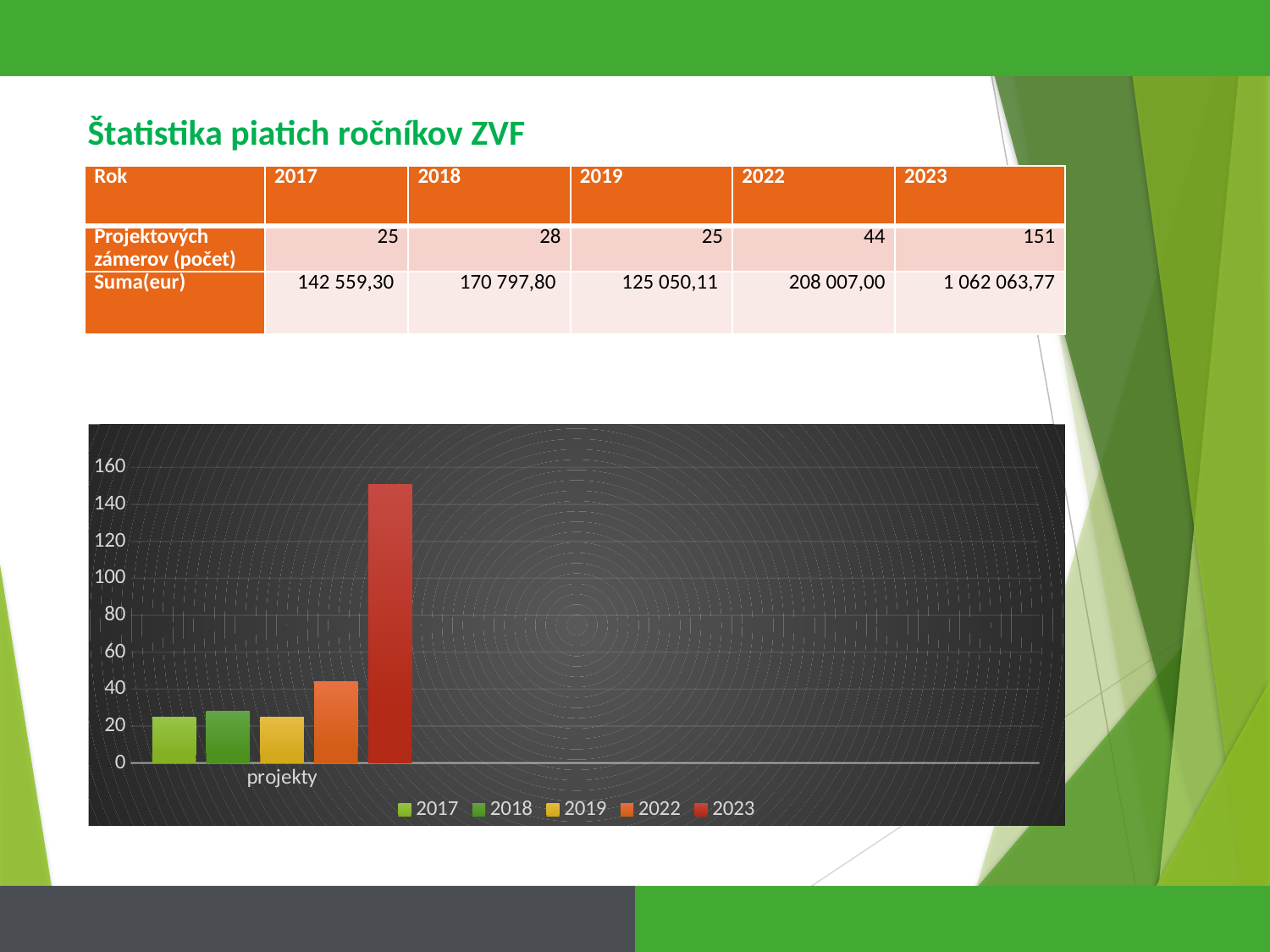
How many series does the chart legend list? 5 Is the value for 2022 in the chart greater or less than 60? less Is the value for 2023 in the chart greater or less than 140? greater Is the value for 2017 in the chart greater or less than 20? greater In the chart, which is larger, the value for 2022 or the value for 2018? 2022 In the chart, which is larger, the value for 2023 or the value for 2022? 2023 What kind of chart is shown on the slide? bar chart Which year has the highest bar in the chart? 2023 What colour is the bar for 2023 in the chart? red How many categories are shown on the x axis of the chart? 1 What is the category label on the x axis of the chart? projekty